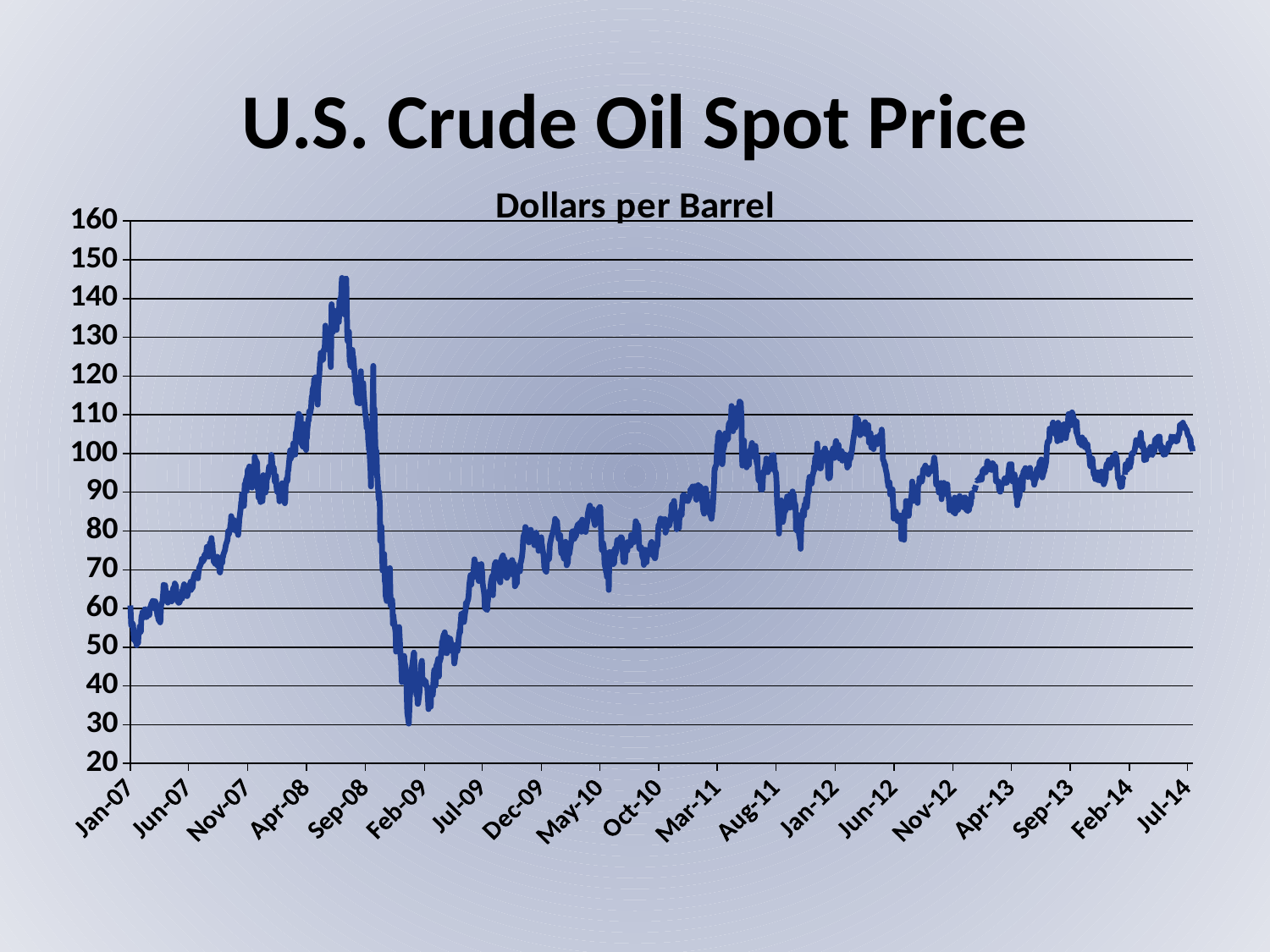
Is the crude oil spot price at Jul-14 greater or less than 90? greater Which is higher: the peak price in 2008 or the peak price in 2011? the peak price in 2008 What is the title of the chart? Dollars per Barrel Is the lowest value of the crude oil spot price in early 2009 greater or less than 40? less What unit is the price measured in, according to the chart subtitle? Dollars per Barrel Does the crude oil spot price rise or fall between Jan-07 and Sep-08? rise Is the peak value of the crude oil spot price in mid-2008 greater or less than 140? greater Does the crude oil spot price rise or fall between Sep-08 and Feb-09? fall How many date labels are shown on the x axis? 19 What kind of chart is shown on the slide? line chart Which is larger: the crude oil spot price around Feb-09 or around Jul-14? Jul-14